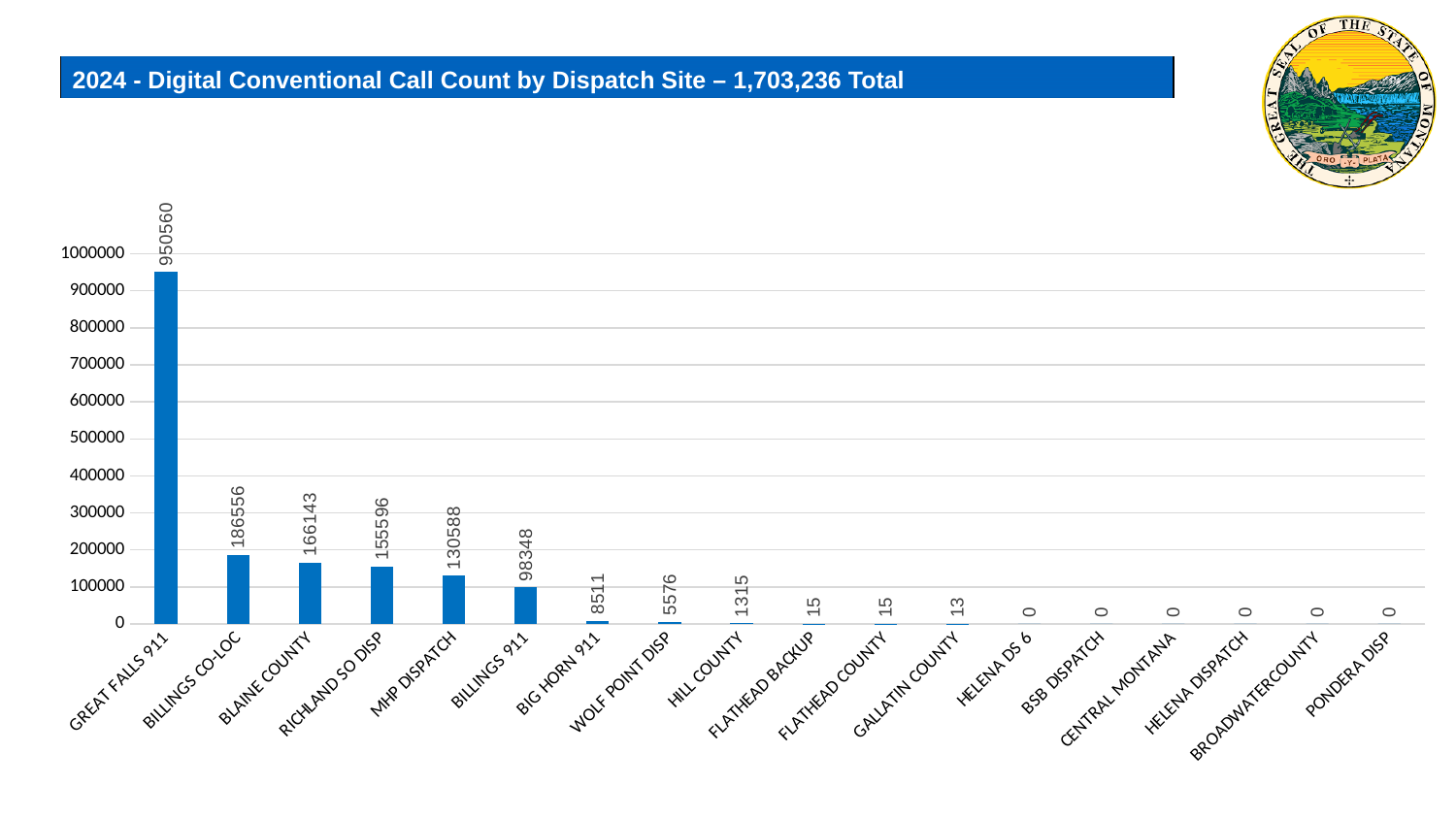
Which has a higher call count, BILLINGS 911 or BIG HORN 911? BILLINGS 911 Which dispatch site has the highest call count? GREAT FALLS 911 How many dispatch sites are shown on the x axis? 18 Is the value for GREAT FALLS 911 greater or less than 900000? greater What kind of chart is shown on the slide? Bar chart What is the call count for BILLINGS CO-LOC? 186556 What is the call count for WOLF POINT DISP? 5576 Do the call counts rise or fall moving from left to right along the x axis? Fall What is the difference in call count between BLAINE COUNTY and RICHLAND SO DISP? 10547 What is the call count for GREAT FALLS 911? 950560 What total call count is stated in the chart title? 1,703,236 What is the call count for MHP DISPATCH? 130588